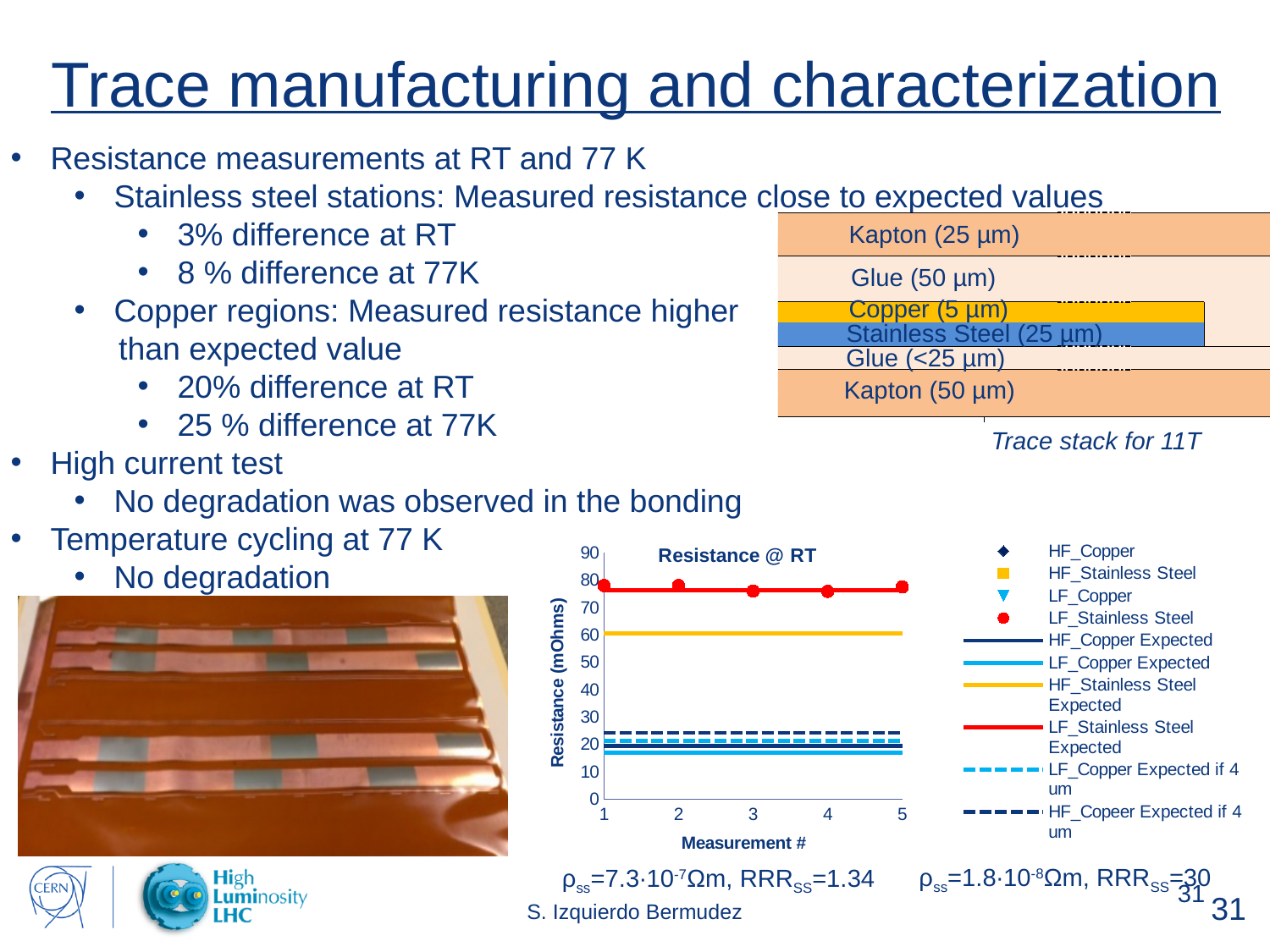
In the 'Resistance @ RT' chart, is the LF_Copper Expected line greater or less than 30? less How many series does the legend of the 'Resistance @ RT' chart list? 10 In the 'Resistance @ RT' chart, do the LF_Stainless Steel measured values stay roughly flat, rise, or fall across measurements 1 to 5? roughly flat In the 'Resistance @ RT' chart, is the HF_Stainless Steel Expected line greater or less than 70? less In the 'Resistance @ RT' chart, is the LF_Stainless Steel value at measurement 3 greater or less than 60? greater In the 'Resistance @ RT' chart, is the LF_Stainless Steel Expected line greater or less than the HF_Stainless Steel Expected line? greater What is the title of the chart on the slide? Resistance @ RT How many measurement numbers are shown along the x-axis of the 'Resistance @ RT' chart? 5 What is the label of the y-axis of the 'Resistance @ RT' chart? Resistance (mOhms) What type of chart is the 'Resistance @ RT' chart? line chart